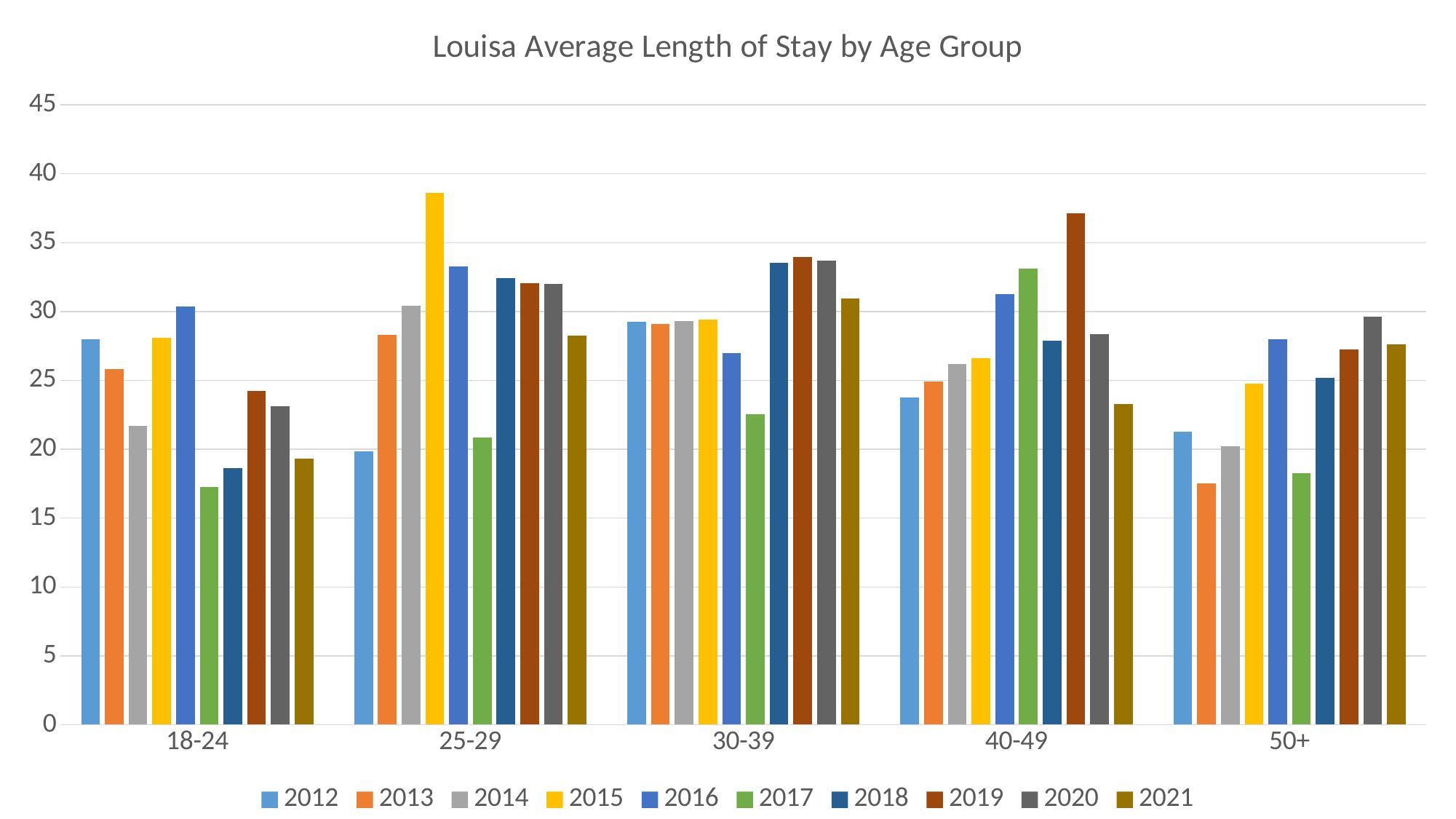
In the 40-49 age group, which is larger: the value for 2019 or the value for 2021? 2019 How many age groups are shown on the x axis? 5 Is the value for 2021 in the 50+ age group greater or less than 25? greater Which year has the highest average length of stay in the 25-29 age group? 2015 How many series (years) does the legend list? 10 Is the value for 2017 in the 18-24 age group greater or less than 20? less Is the value for 2015 in the 25-29 age group greater or less than 35? greater Which year has the lowest average length of stay in the 18-24 age group? 2017 What is the title of the chart? Louisa Average Length of Stay by Age Group Which year has the highest average length of stay in the 40-49 age group? 2019 Which year has the lowest average length of stay in the 30-39 age group? 2017 What type of chart is shown on the slide? Bar chart